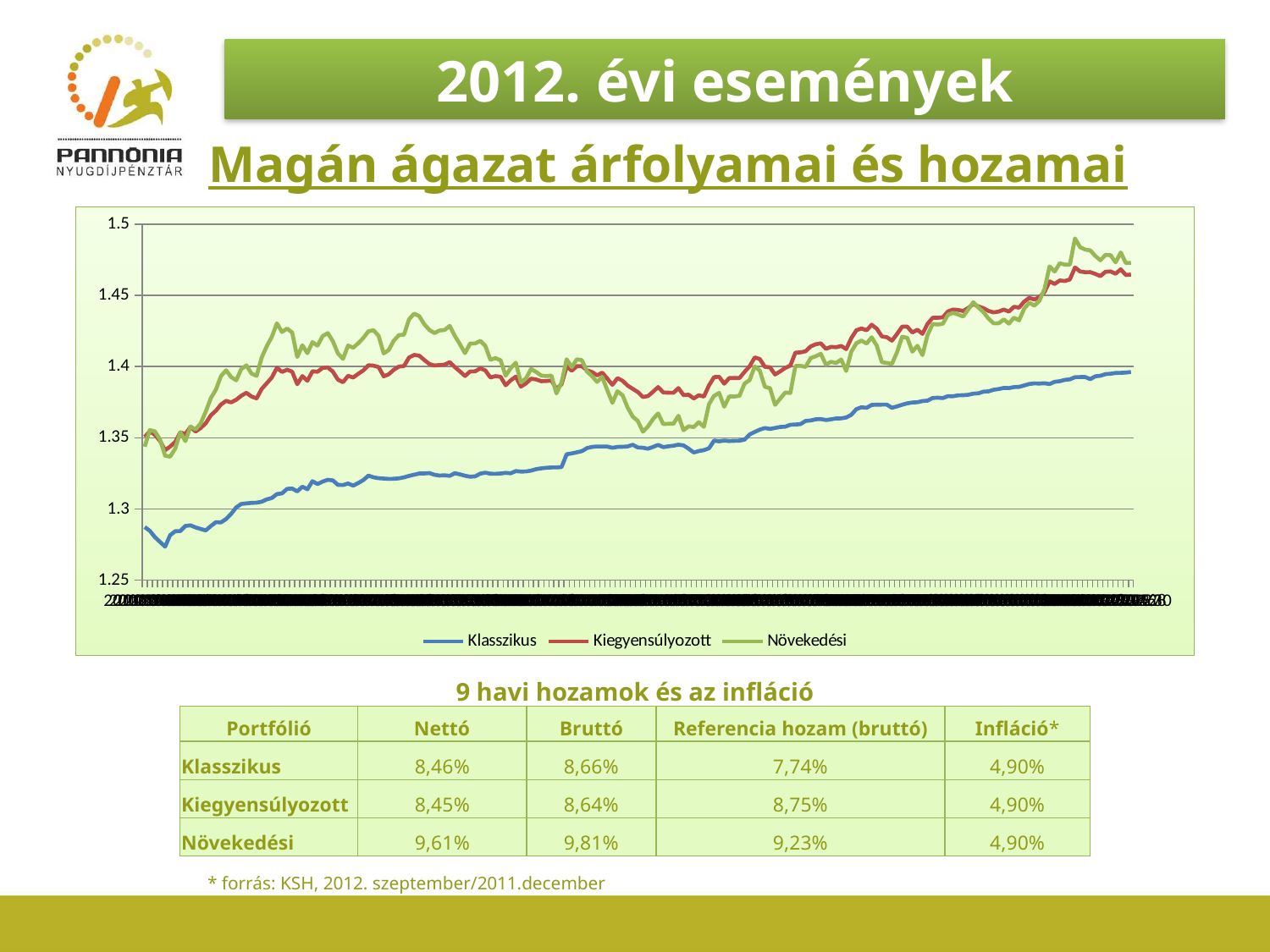
Is the starting value of the Klasszikus line greater or less than 1.3? less Which series stays lowest across the whole chart? Klasszikus Which series reaches the highest value on the chart? Növekedési Does the Klasszikus line rise or fall overall from left to right? rise Which series is shown in blue in the chart? Klasszikus Is the value of the Kiegyensúlyozott line at the right end of the chart greater or less than 1.45? greater How many series does the chart legend list? 3 Does the Klasszikus line ever exceed 1.4 on the chart? no What kind of chart is shown on the slide? line chart At the right end of the chart, which is higher: Növekedési or Klasszikus? Növekedési Which series is shown in green in the chart? Növekedési